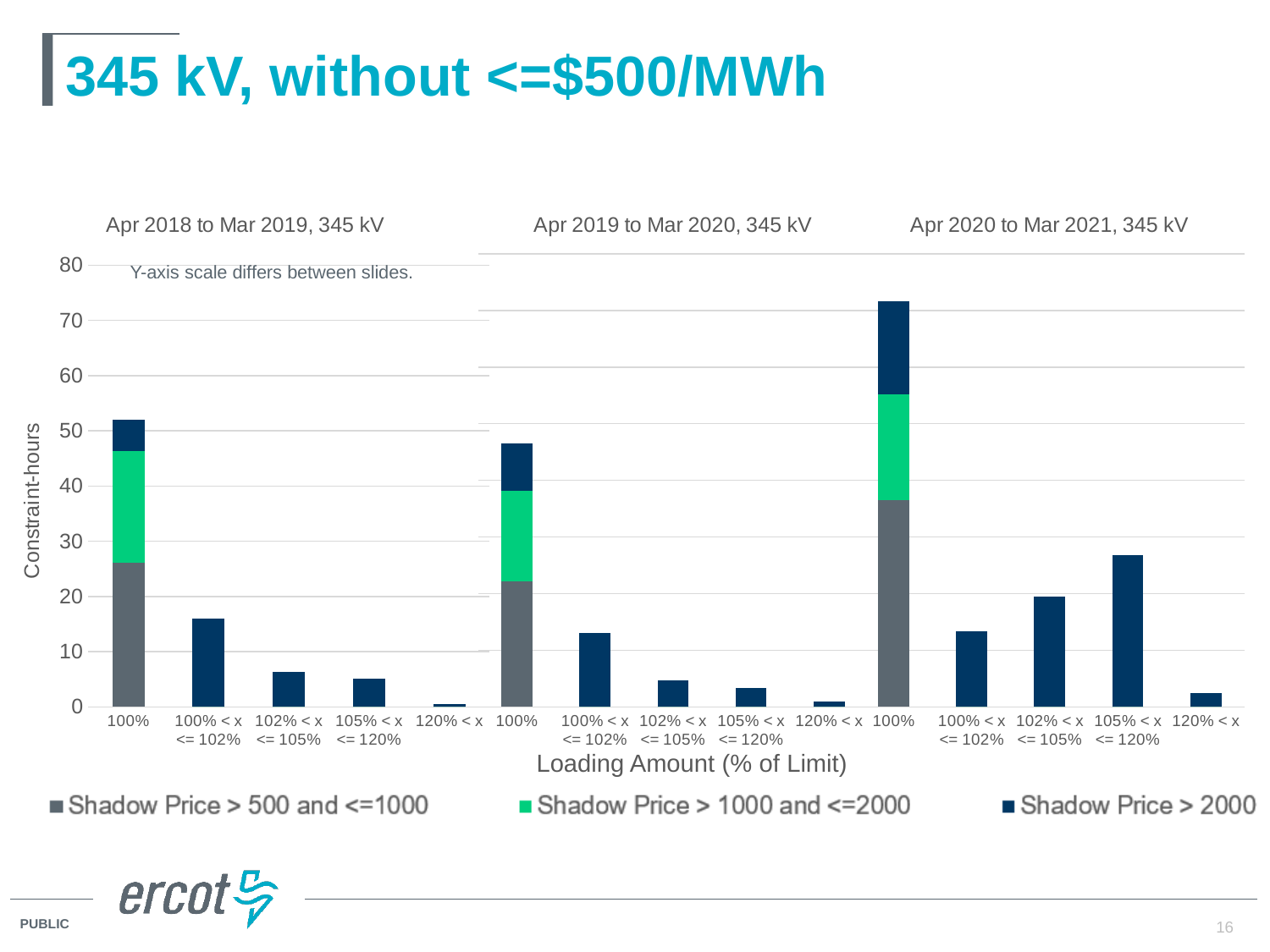
Which of the three charts has the tallest bar for the 100% category? Apr 2020 to Mar 2021, 345 kV In the Apr 2018 to Mar 2019, 345 kV chart, which loading amount category has the lowest constraint-hours? 120% < x How many series does the legend list? 3 In the Apr 2018 to Mar 2019, 345 kV chart, how many loading amount categories are shown on the x axis? 5 In the Apr 2019 to Mar 2020, 345 kV chart, is the value for the 100% < x <= 102% category greater or less than 20? less What is the label on the y axis of the chart? Constraint-hours In the Apr 2020 to Mar 2021, 345 kV chart, which loading amount category has the highest total constraint-hours? 100% In the Apr 2018 to Mar 2019, 345 kV chart, is the total value for the 100% category greater or less than 40? greater What kind of chart is shown on the slide? Stacked bar chart In the Apr 2018 to Mar 2019, 345 kV chart, which is larger: the value for 100% < x <= 102% or the value for 102% < x <= 105%? 100% < x <= 102% In the Apr 2020 to Mar 2021, 345 kV chart, is the total value for the 100% category greater or less than 60? greater In the Apr 2020 to Mar 2021, 345 kV chart, which is larger: the value for 102% < x <= 105% or the value for 105% < x <= 120%? 105% < x <= 120%